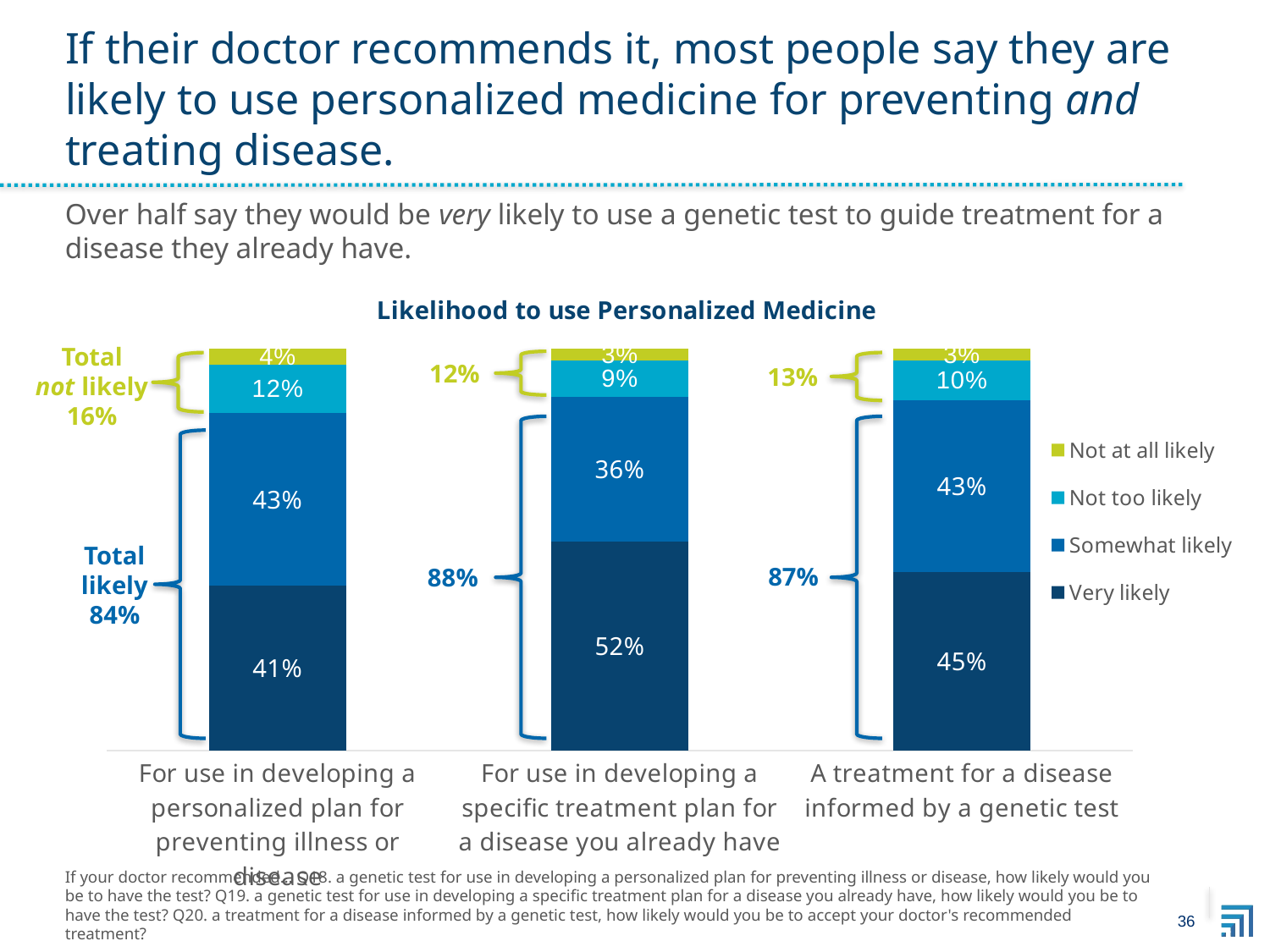
What is the 'Total likely' percentage shown for 'For use in developing a specific treatment plan for a disease you already have'? 88% Which is larger: the 'Not at all likely' value for the personalized prevention plan or for the treatment informed by a genetic test? Personalized plan for preventing illness or disease (4%) What is the 'Somewhat likely' value for 'For use in developing a personalized plan for preventing illness or disease'? 43% What is the title of the chart? Likelihood to use Personalized Medicine What is the 'Not too likely' value for 'A treatment for a disease informed by a genetic test'? 10% What is the difference between the 'Very likely' values for 'A treatment for a disease informed by a genetic test' and 'For use in developing a personalized plan for preventing illness or disease'? 4% How many categories (bars) are shown in the chart? 3 What kind of chart is shown on the slide? Stacked bar chart Which category has the lowest 'Somewhat likely' value? For use in developing a specific treatment plan for a disease you already have Which category has the highest 'Very likely' value? For use in developing a specific treatment plan for a disease you already have What percentage of respondents are 'Very likely' to use a genetic test for developing a specific treatment plan for a disease they already have? 52% How many series does the chart legend list? 4